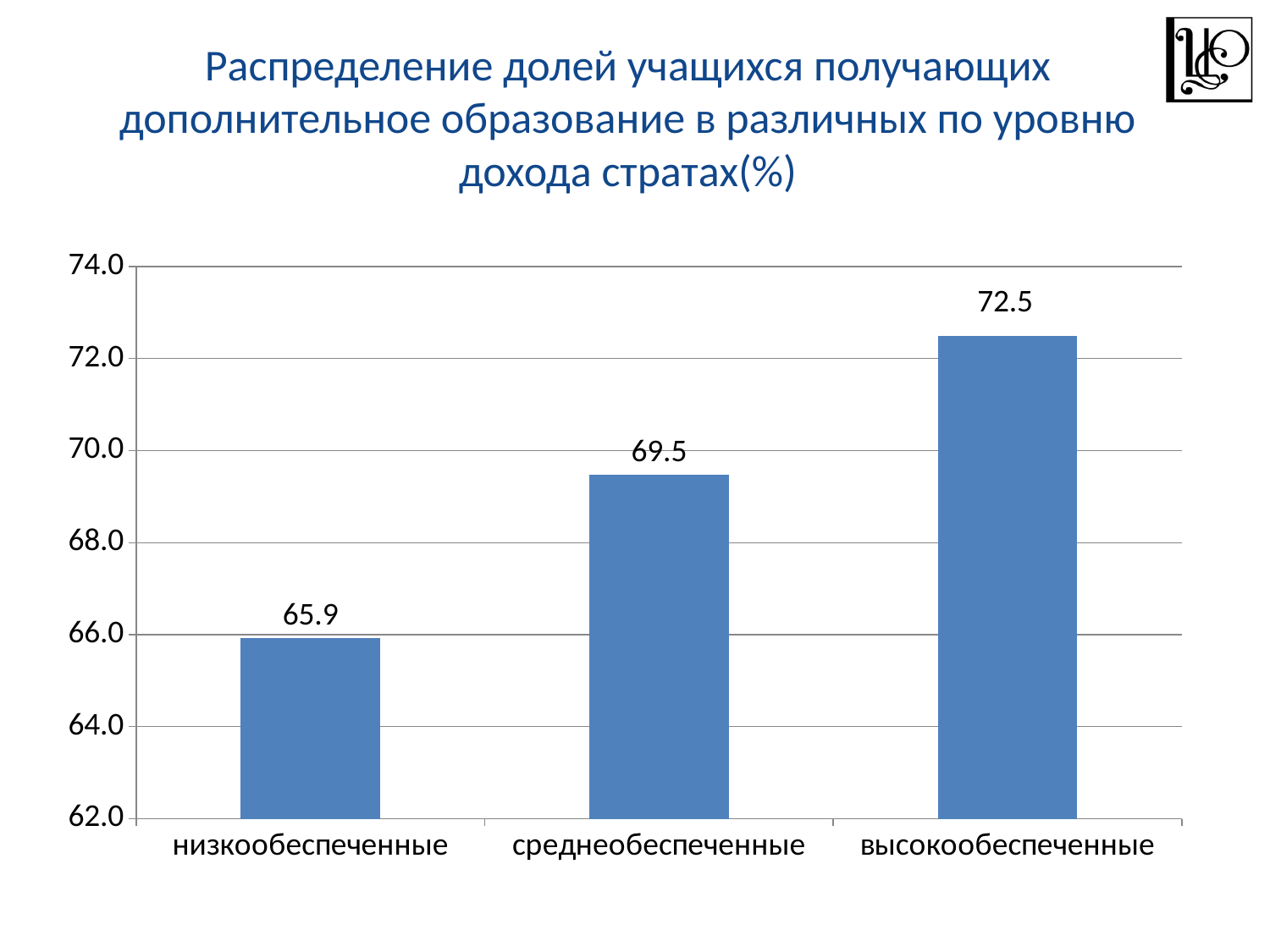
What is the difference between the values for среднеобеспеченные and низкообеспеченные? 3.6 What is the value for среднеобеспеченные? 69.5 What kind of chart is shown on the slide? bar chart What is the value for низкообеспеченные? 65.9 What is the difference between the values for высокообеспеченные and низкообеспеченные? 6.6 Is the value for среднеобеспеченные greater or less than 70.0? less Do the values rise or fall from left to right along the x axis? rise Which category has the highest value? высокообеспеченные What is the value for высокообеспеченные? 72.5 Which category has the lowest value? низкообеспеченные Which is larger, the value for среднеобеспеченные or the value for высокообеспеченные? высокообеспеченные How many categories are shown on the x axis? 3